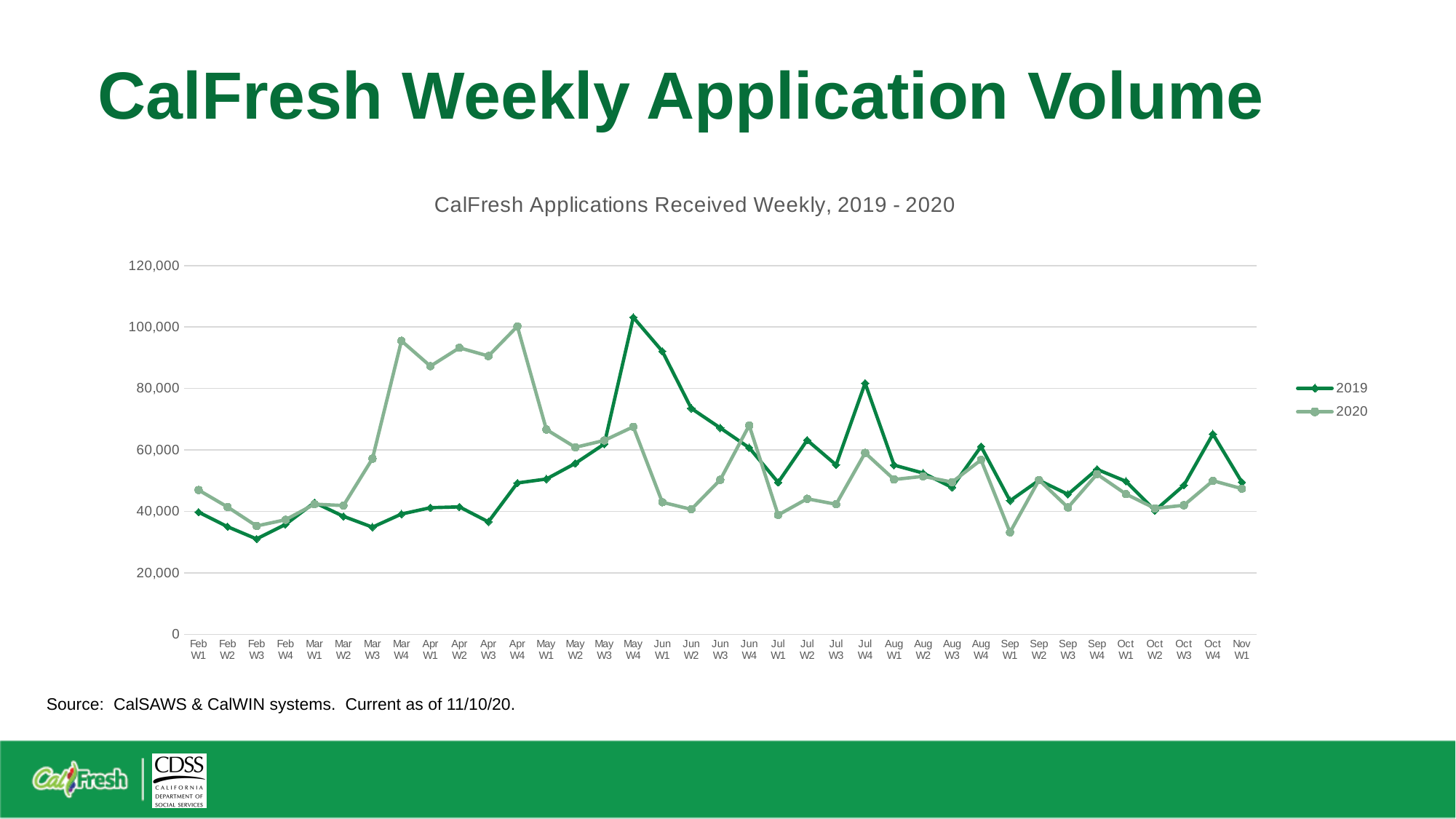
What are the two series named in the legend? 2019 and 2020 In which week does the 2020 series reach its highest value? Apr W4 What is the title of the chart? CalFresh Applications Received Weekly, 2019 - 2020 In which week does the 2019 series reach its lowest value? Feb W3 What type of chart is shown on the slide? Line chart In which week does the 2019 series reach its highest value? May W4 Which series has the larger value in Apr W4, 2019 or 2020? 2020 Does the 2020 series rise or fall from Mar W1 to Mar W4? Rises How many weekly points are plotted along the x axis? 37 Is the 2020 value for Sep W1 greater or less than 40,000? less Is the 2019 value for May W4 greater or less than 100,000? greater How many series does the legend list? 2